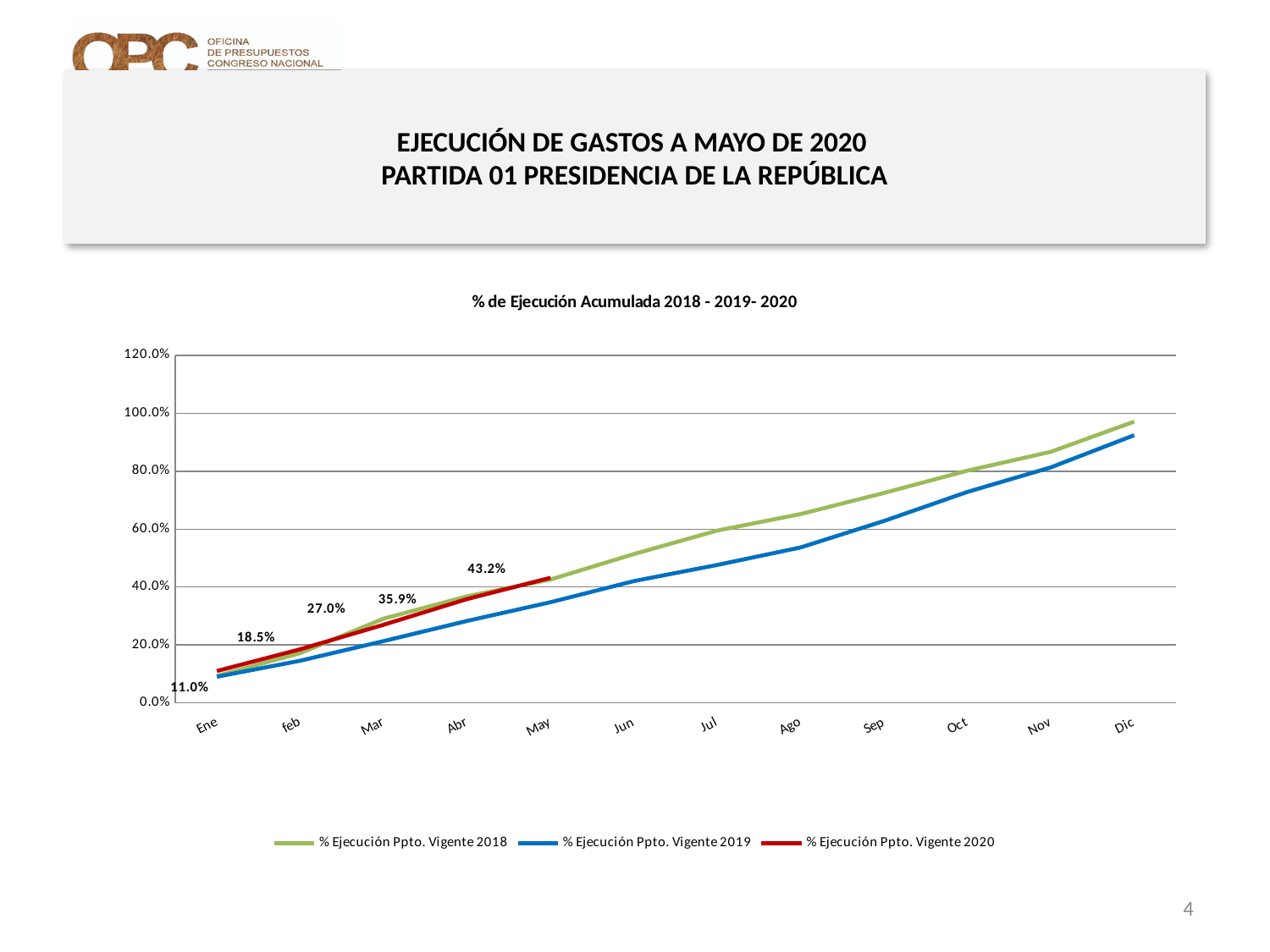
What is the value of % Ejecución Ppto. Vigente 2020 in Mar? 27.0% What is the value of % Ejecución Ppto. Vigente 2020 in May? 43.2% What is the value of % Ejecución Ppto. Vigente 2020 in Ene? 11.0% How many series does the legend list? 3 By how many percentage points did % Ejecución Ppto. Vigente 2020 increase from Ene to May? 32.2 percentage points What kind of chart is shown on the slide? Line chart Do the values of % Ejecución Ppto. Vigente 2018 rise or fall from Ene to Dic? Rise Is the value for % Ejecución Ppto. Vigente 2019 in Ago greater or less than 60.0%? less How many months are shown on the x axis? 12 Which series has the higher value in Dic, % Ejecución Ppto. Vigente 2018 or % Ejecución Ppto. Vigente 2019? % Ejecución Ppto. Vigente 2018 In which month does the % Ejecución Ppto. Vigente 2020 series reach its highest labelled value? May What is the difference between the % Ejecución Ppto. Vigente 2020 values for Abr and Mar? 8.9 percentage points